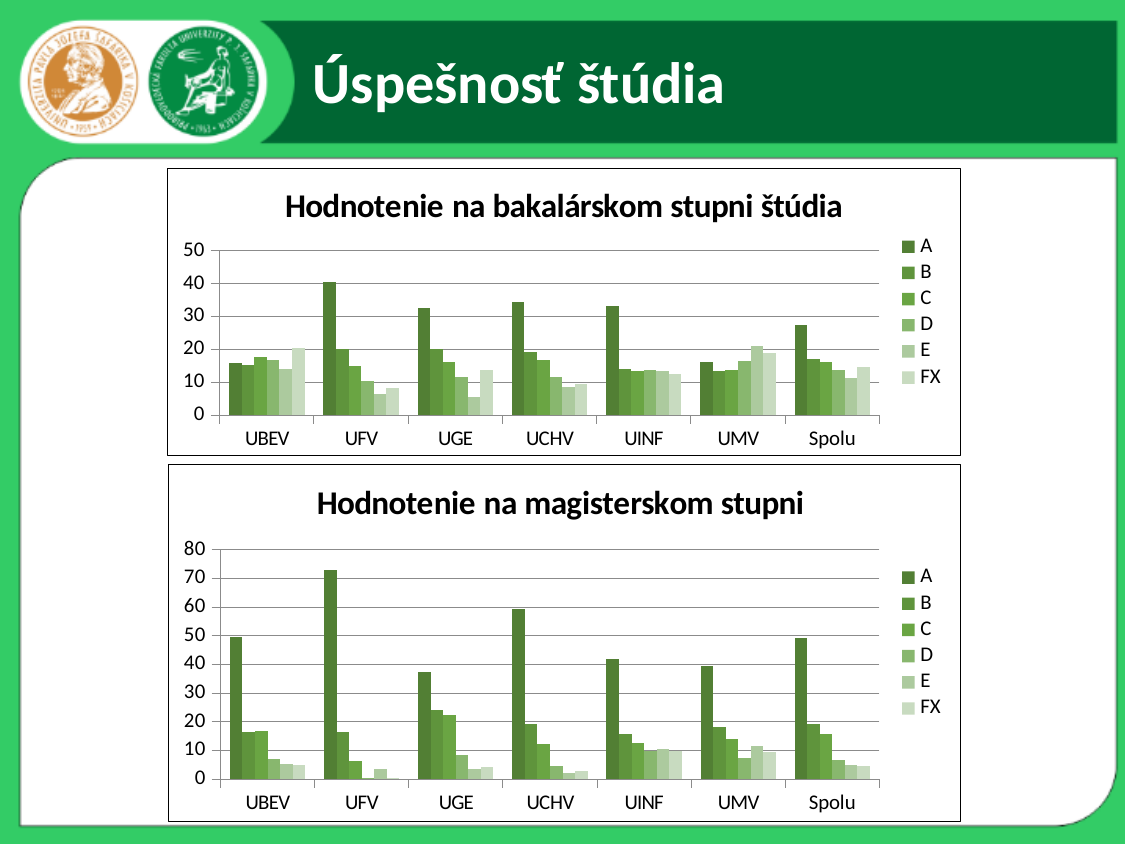
How many categories are shown on the x axis of the top chart, 'Hodnotenie na bakalárskom stupni štúdia'? 7 In the top chart, 'Hodnotenie na bakalárskom stupni štúdia', is the value of series A for UFV greater or less than 30? greater In the top chart, 'Hodnotenie na bakalárskom stupni štúdia', which category has the highest value for series A? UFV In the bottom chart, 'Hodnotenie na magisterskom stupni', which is larger for UFV: series A or series B? A How many series does the legend of the bottom chart, 'Hodnotenie na magisterskom stupni', list? 6 In the bottom chart, 'Hodnotenie na magisterskom stupni', is the value of series A for UCHV greater or less than 50? greater In the bottom chart, 'Hodnotenie na magisterskom stupni', is the value of series A for UFV greater or less than 60? greater What type of chart is the top chart, 'Hodnotenie na bakalárskom stupni štúdia'? bar chart What is the title of the bottom chart on the slide? Hodnotenie na magisterskom stupni In the bottom chart, 'Hodnotenie na magisterskom stupni', which category has the highest value for series A? UFV In the top chart, 'Hodnotenie na bakalárskom stupni štúdia', which is larger for UBEV: series A or series FX? FX